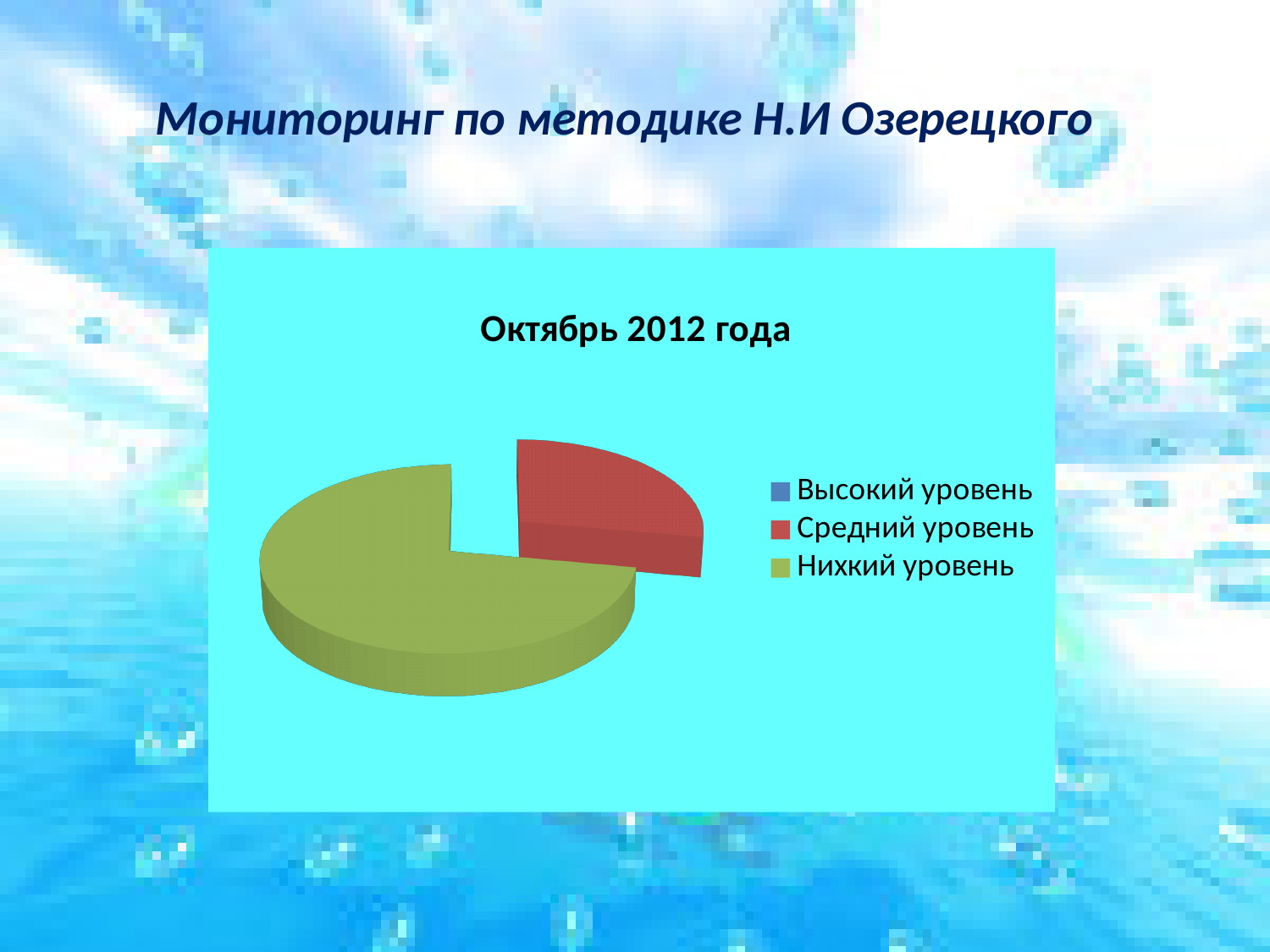
What kind of chart is shown on the slide? pie chart Is the share of the pie for Средний уровень greater or less than 50%? less What colour is the slice for Средний уровень? red What is the title of the chart? Октябрь 2012 года Which is larger, the slice for Средний уровень or the slice for Нихкий уровень? Нихкий уровень How many entries does the chart legend list? 3 Which category has the smallest share of the pie? Высокий уровень Which category has the largest slice of the pie? Нихкий уровень Is the share of the pie for Нихкий уровень greater or less than 50%? greater